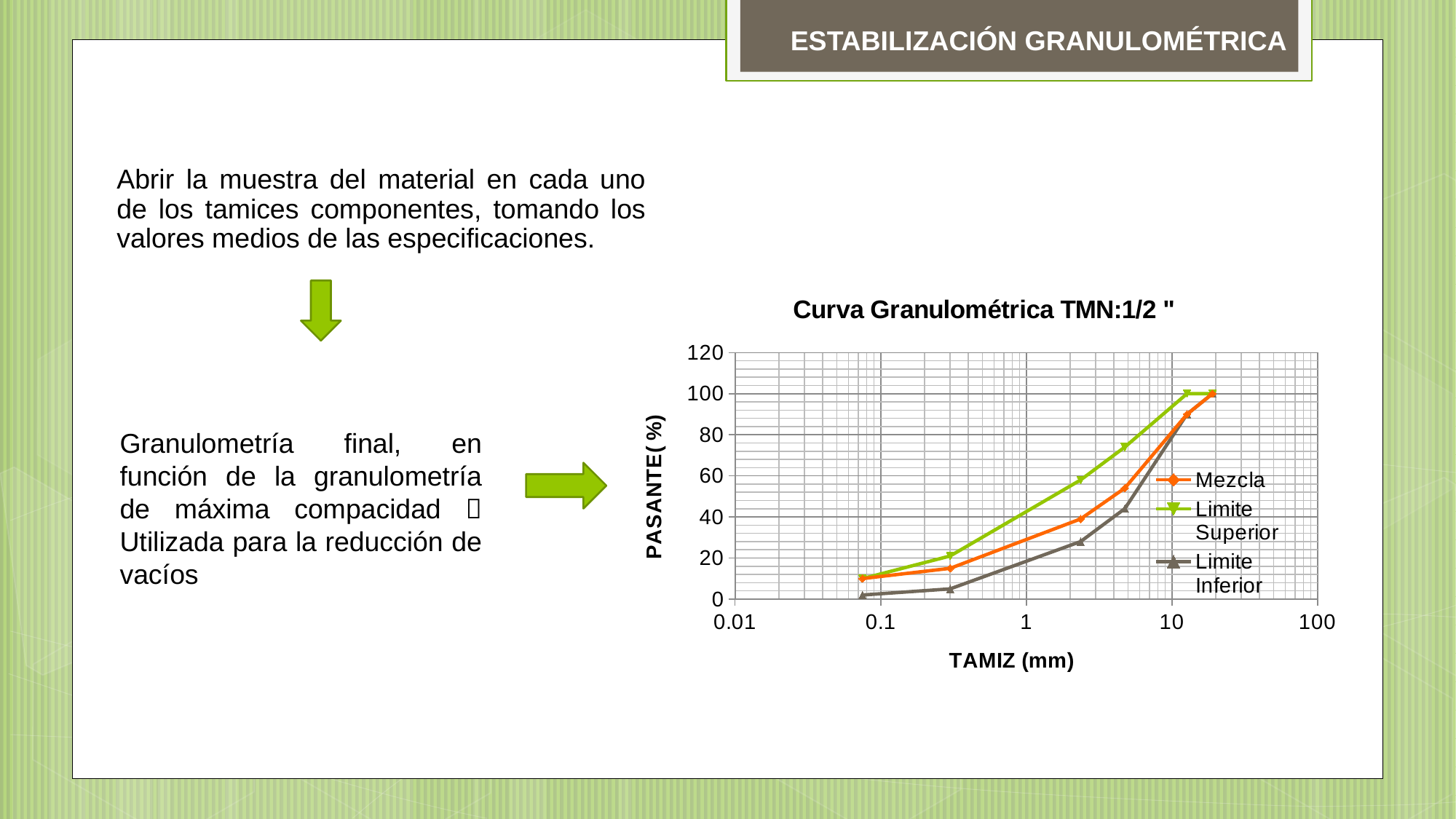
Do the values of the Mezcla series rise or fall as the sieve size (TAMIZ) increases? rise What PASANTE (%) value do all three series reach at the largest sieve size plotted? 100 What is the title of the chart? Curva Granulométrica TMN:1/2 " Which series has the lowest values across the chart? Limite Inferior What is the label of the y axis of the chart? PASANTE( %) Is the value of Limite Superior at about 5 mm greater or less than 60? greater Which series lies highest across the chart, Limite Superior or Limite Inferior? Limite Superior How many series does the legend of the chart list? 3 What kind of chart is shown on the slide? line chart Is the value of Limite Inferior at its smallest sieve size (near 0.1 mm) greater or less than 20? less Is the value of Limite Inferior at about 2 mm greater or less than 40? less